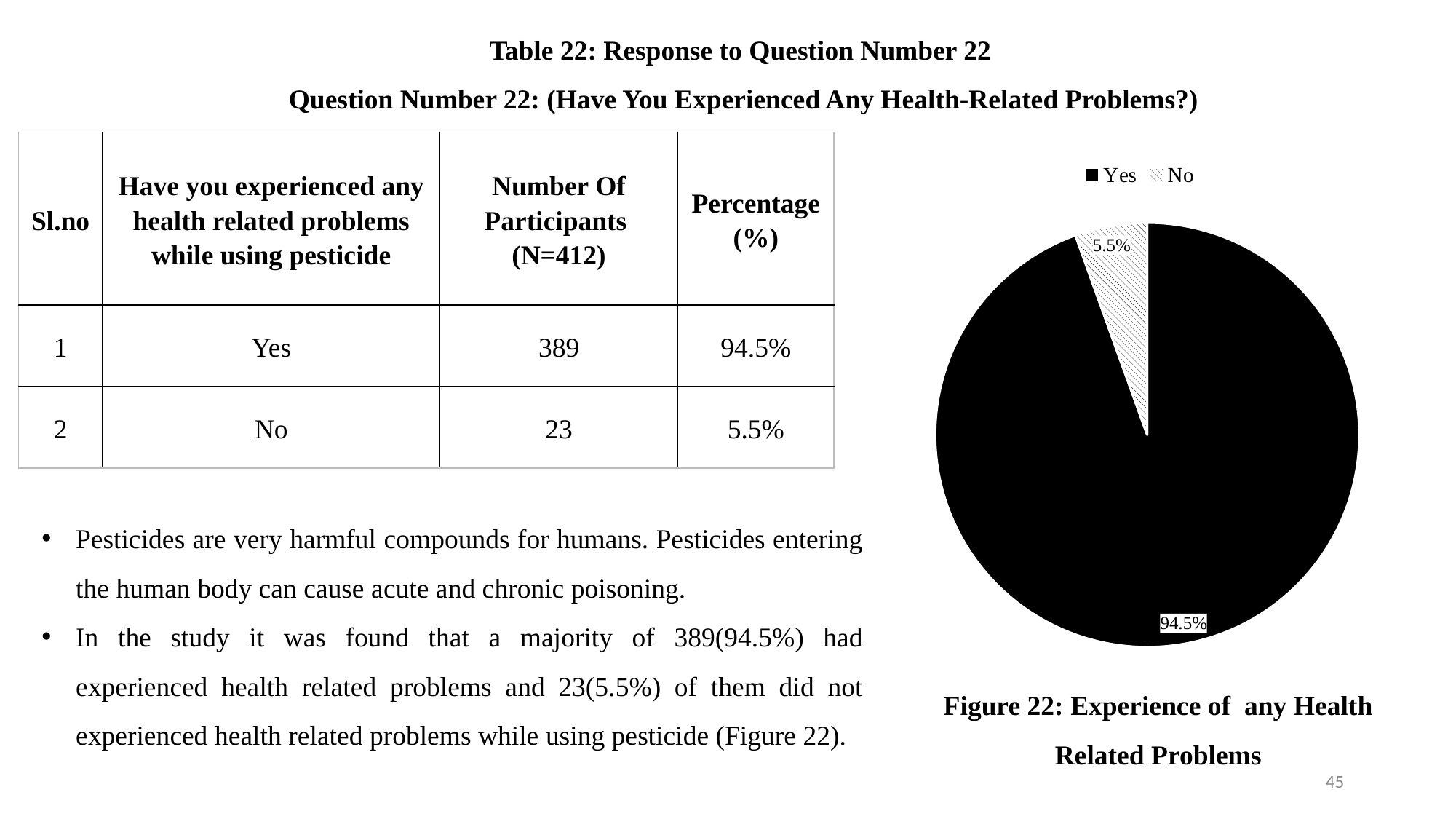
Which slice of the pie chart is the smallest? No What is the title of the pie chart figure? Figure 22: Experience of any Health Related Problems Which slice of the pie chart is the largest? Yes In the pie chart, which slice is larger, Yes or No? Yes How many entries does the legend of the pie chart list? 2 In the pie chart, what percentage is shown for the Yes slice? 94.5% What kind of chart is shown in Figure 22? pie chart In the pie chart legend, which entry is shown with a hatched pattern? No What is the difference in percentage points between the Yes and No slices in the pie chart? 89 percentage points How many slices does the pie chart have? 2 In the pie chart, what percentage is shown for the No slice? 5.5% What share of the pie does the Yes slice represent? 94.5%